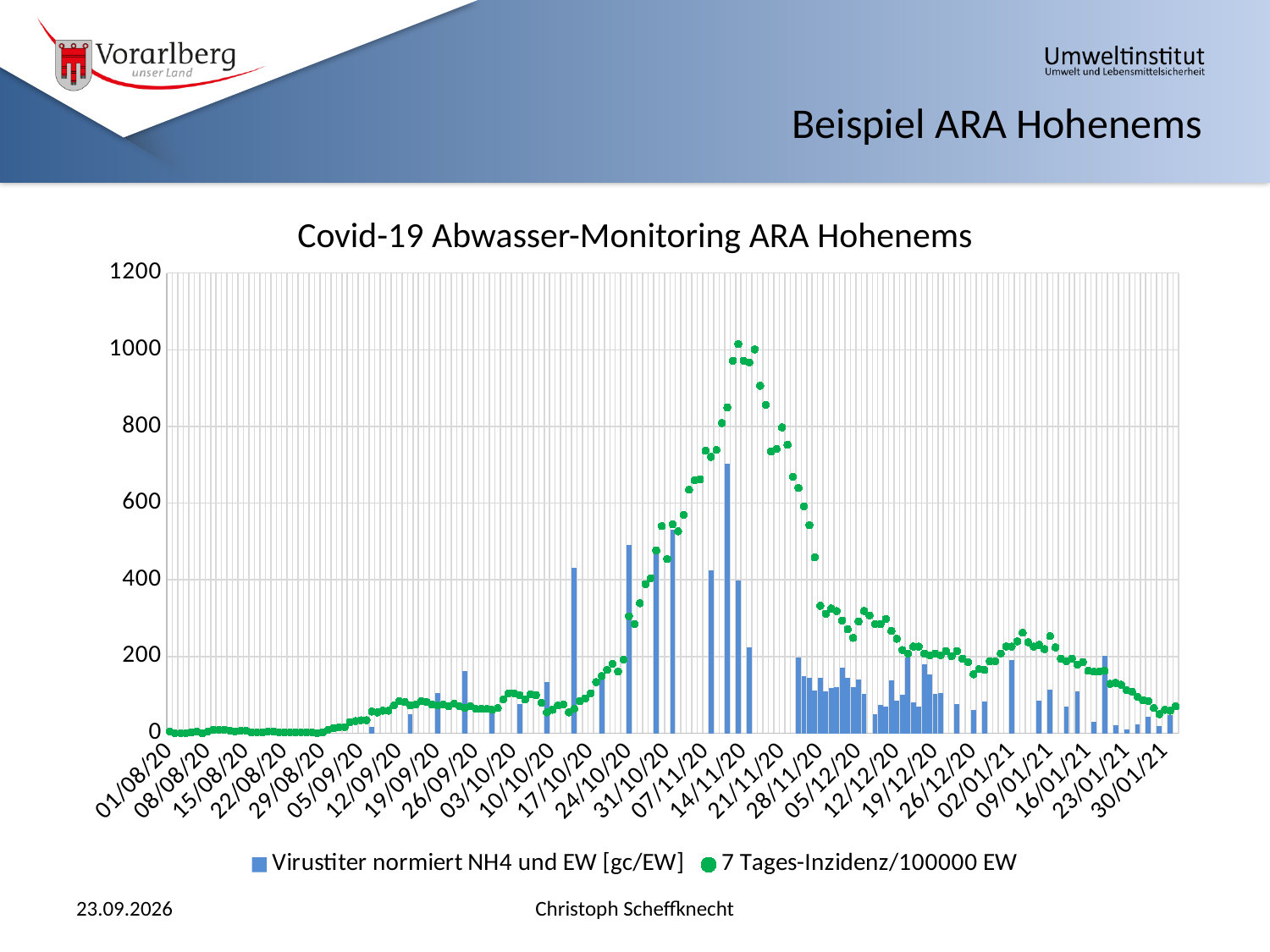
Which series reaches a higher peak value, the Virustiter bars or the 7 Tages-Inzidenz dots? 7 Tages-Inzidenz/100000 EW Does the 7 Tages-Inzidenz/100000 EW series rise or fall between 14/11/20 and 30/01/21? fall Is the 7 Tages-Inzidenz/100000 EW value on 01/08/20 greater or less than 200? less Is the tallest Virustiter bar greater or less than 600? greater What is the title of the chart? Covid-19 Abwasser-Monitoring ARA Hohenems What is the highest value shown on the vertical axis? 1200 Is the peak value of the 7 Tages-Inzidenz/100000 EW series greater or less than 800? greater How many series does the chart legend list? 2 Which series is shown as blue bars? Virustiter normiert NH4 und EW [gc/EW] What kind of chart is used for the 7 Tages-Inzidenz/100000 EW series? Scatter (dot) chart Does the 7 Tages-Inzidenz/100000 EW series rise or fall between 01/08/20 and 14/11/20? rise Around which x-axis date does the 7 Tages-Inzidenz/100000 EW series reach its maximum? 14/11/20